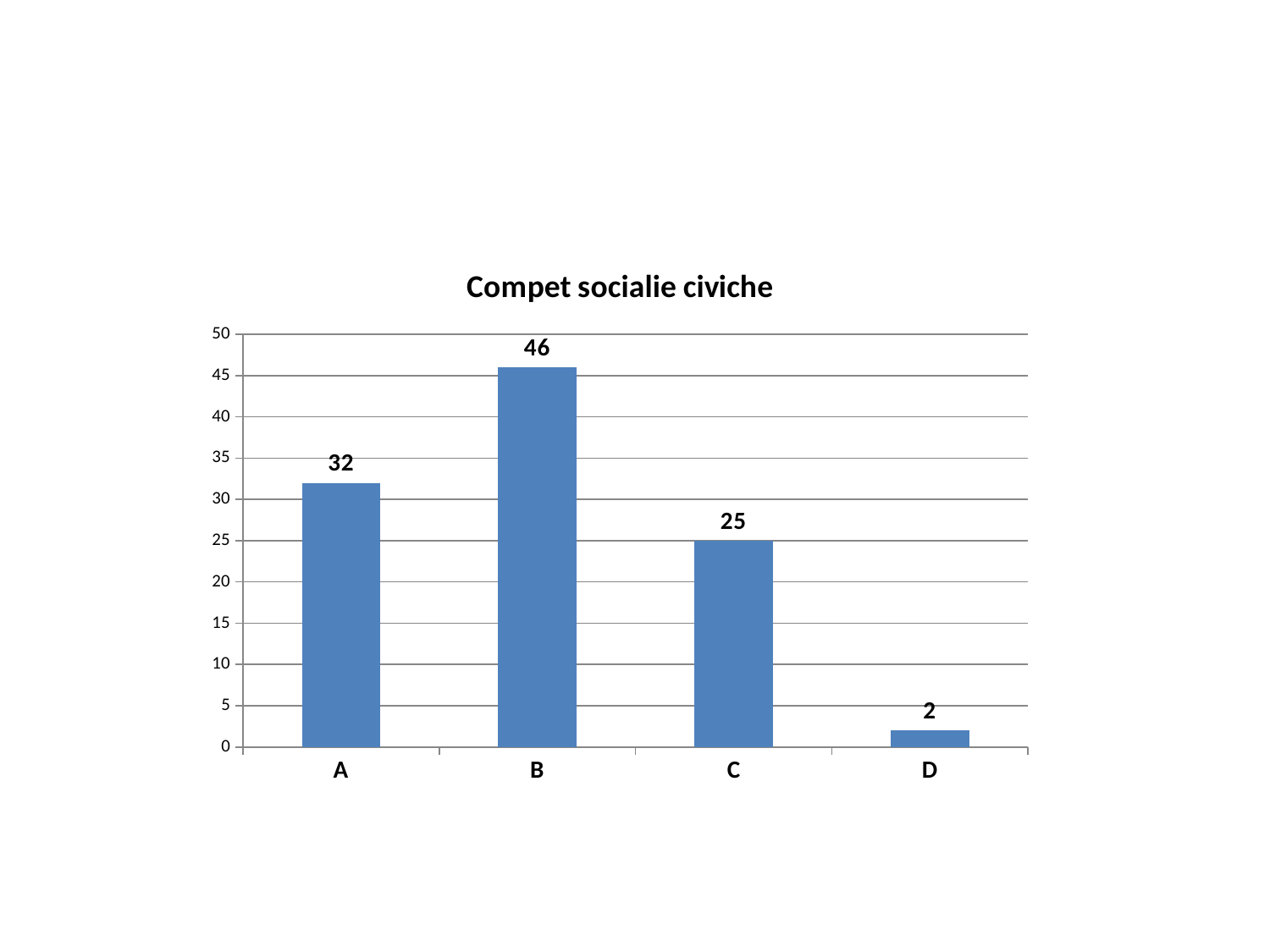
What is the value for category B? 46 What is the difference between the values for C and D? 23 Which category has the lowest value? D What is the difference between the values for B and A? 14 How many categories are shown on the x axis? 4 Which is larger, the value for A or the value for C? A Which category has the highest value? B What is the value for category C? 25 What is the value for category A? 32 What kind of chart is shown on the slide? bar chart Is the value for B greater or less than 40? greater What is the value for category D? 2